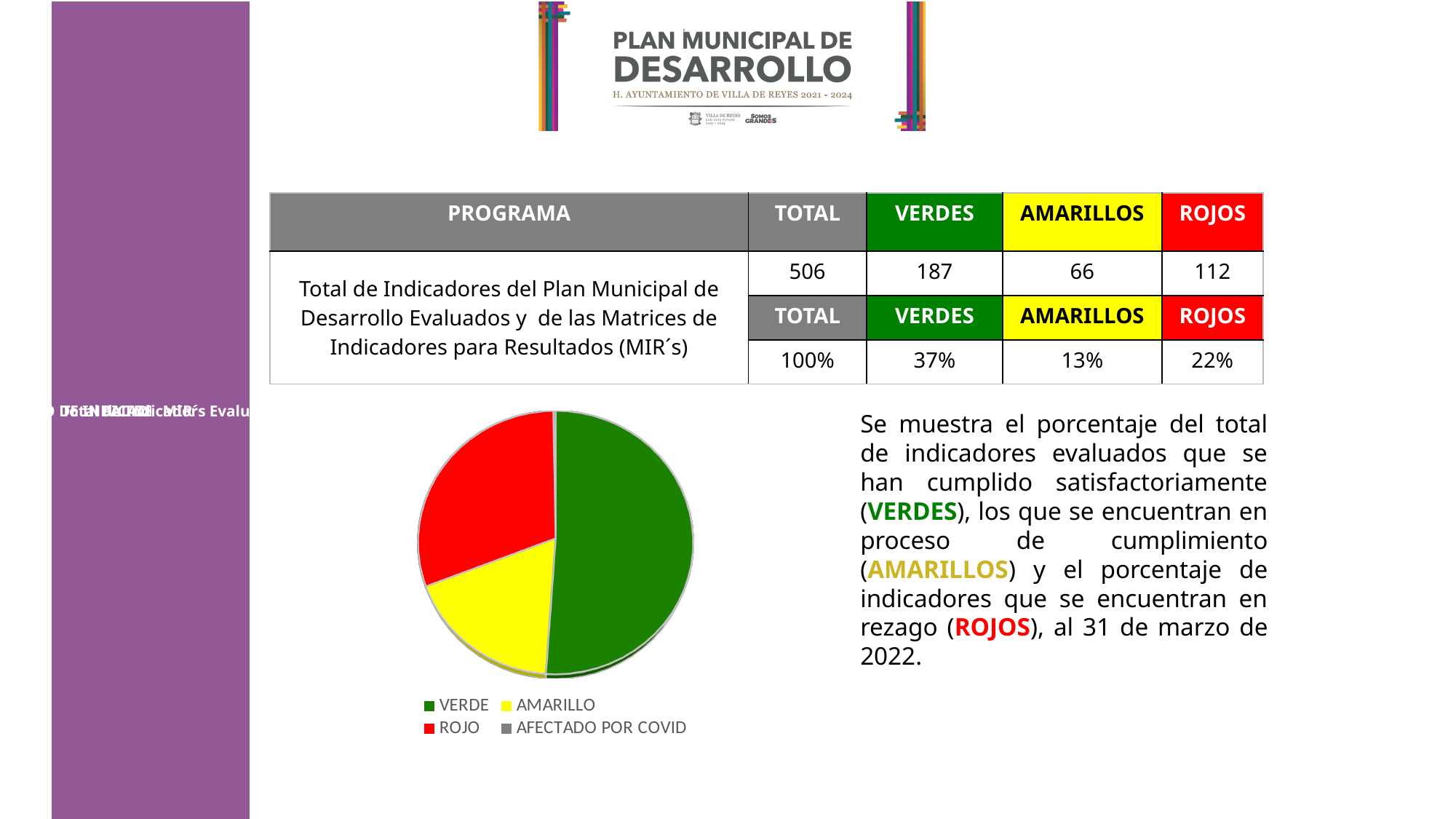
In the pie chart, which slice is larger, VERDE or ROJO? VERDE Which category has the largest slice in the pie chart? VERDE What kind of chart is shown on the slide? Pie chart Which legend entry of the pie chart is shown in grey? AFECTADO POR COVID In the pie chart, which slice is larger, ROJO or AMARILLO? ROJO How many entries does the pie chart's legend list? 4 How many slices are visible in the pie chart? 3 What colour represents the ROJO category in the pie chart? Red Which of the visible slices in the pie chart is the smallest? AMARILLO In the pie chart, which slice is larger, AMARILLO or VERDE? VERDE